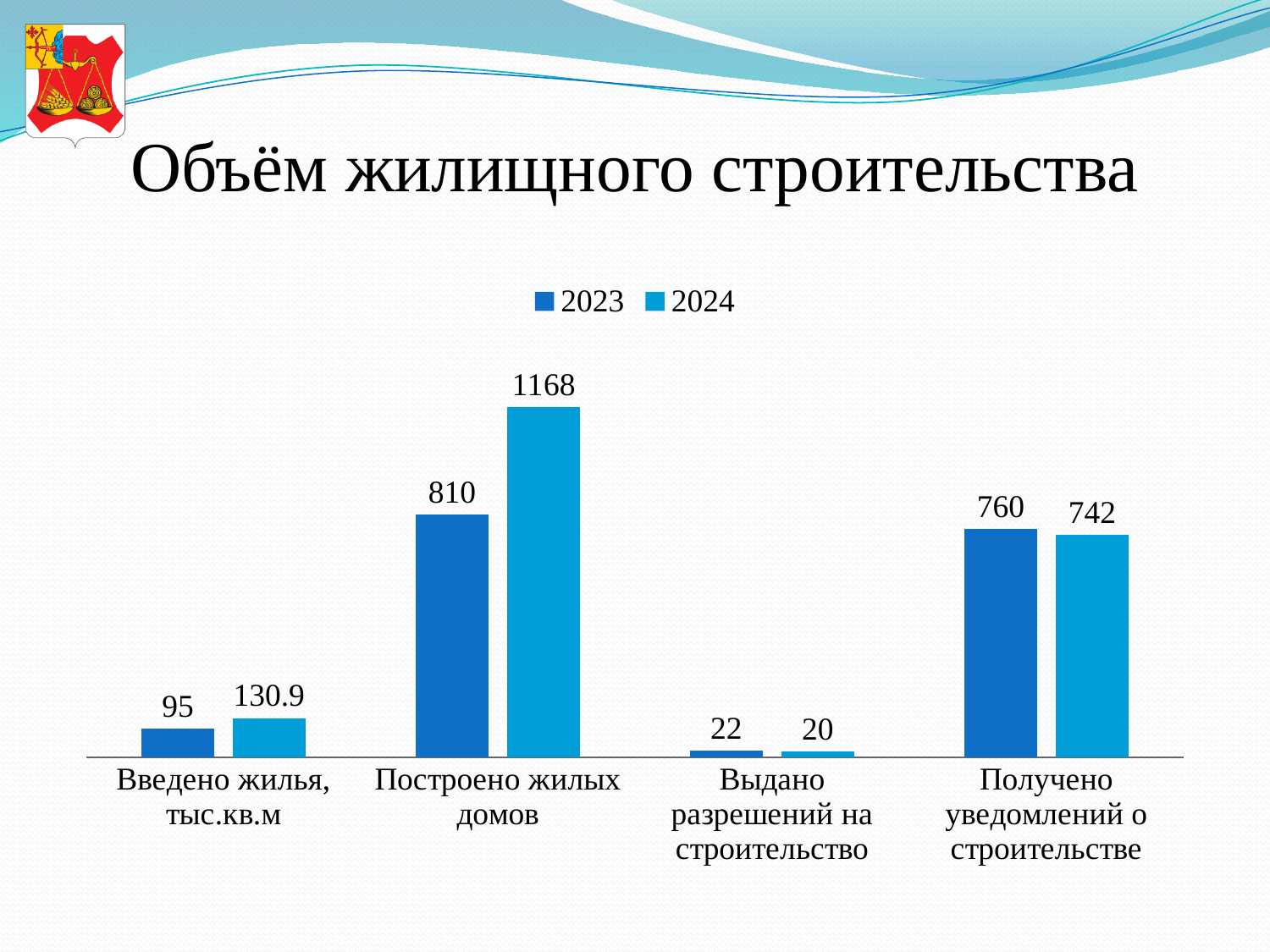
What is the difference between the 2024 and 2023 values for "Построено жилых домов"? 358 What is the 2023 value for "Получено уведомлений о строительстве"? 760 Which category has the highest 2024 value? Построено жилых домов What is the 2024 value for "Выдано разрешений на строительство"? 20 What kind of chart is shown on the slide? Bar chart What is the 2023 value for "Построено жилых домов"? 810 What is the 2024 value for "Введено жилья, тыс.кв.м"? 130.9 For "Введено жилья, тыс.кв.м", which year has the larger value, 2023 or 2024? 2024 How many categories are shown on the x axis? 4 What is the difference between the 2023 and 2024 values for "Получено уведомлений о строительстве"? 18 How many series does the legend list? 2 Which category has the lowest 2023 value? Выдано разрешений на строительство